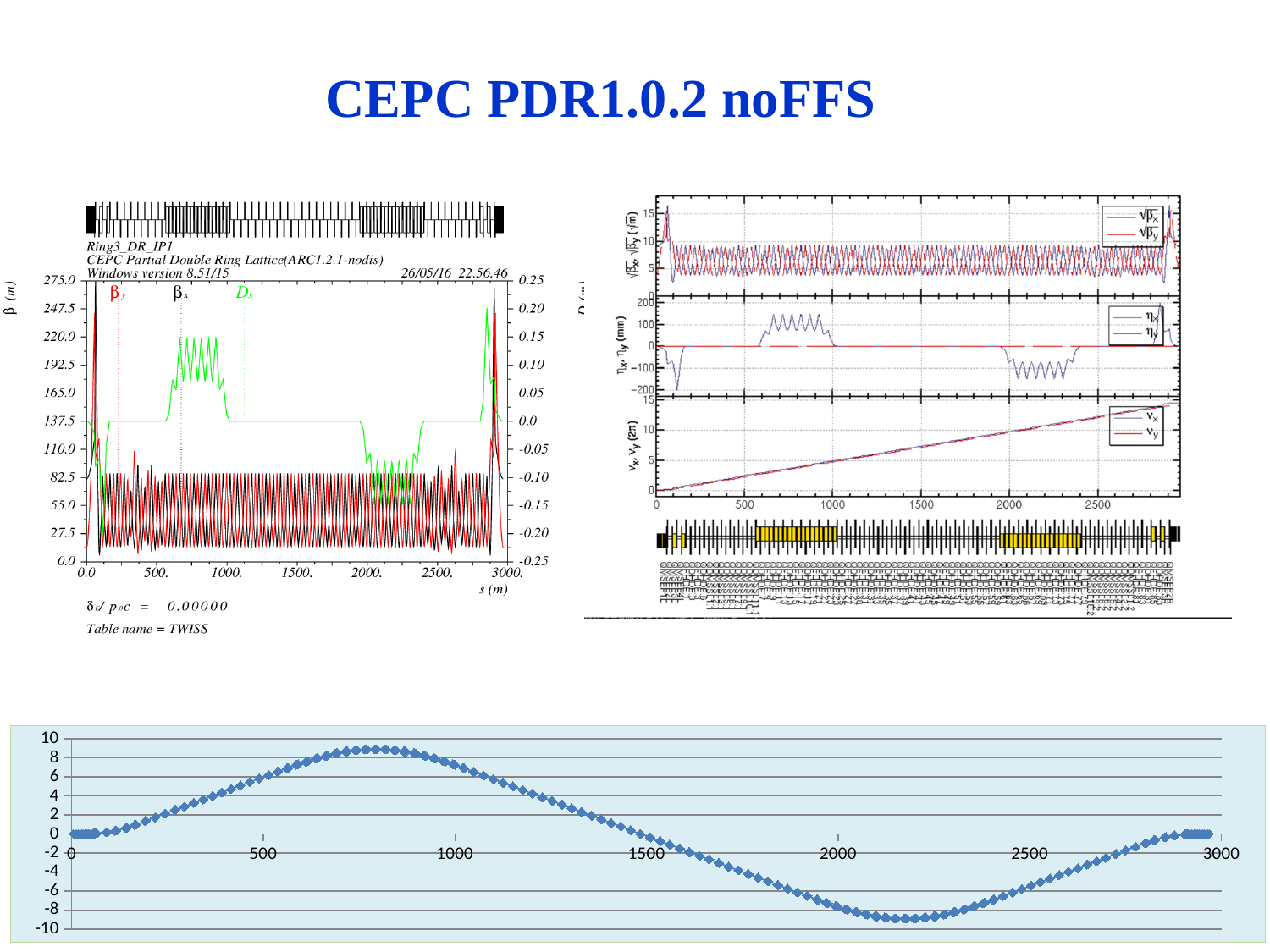
In the top-left chart, how many series are identified in the legend (βy, βx, Dx)? 3 In the bottom chart, do the plotted values rise or fall as x goes from 1000 to 2000? fall In the top-right chart's middle panel, is the ηx value at s = 2200 greater or less than -50 mm? less In the top-right chart's bottom panel, do the νx and νy values rise or fall as s increases from 0 to 2500? rise In the bottom chart, is the plotted value at x = 2200 greater or less than -5? less In the bottom chart, what is the maximum value shown on the vertical axis? 10 In the top-left chart, what is the maximum value labelled on the left β (m) axis? 275.0 In the top-left chart, is the Dx value at s = 800 m greater or less than 0.10? greater In the bottom chart, what is the largest value labelled on the horizontal axis? 3000 In the bottom chart, do the plotted values rise or fall as x goes from 2300 to 2900? rise